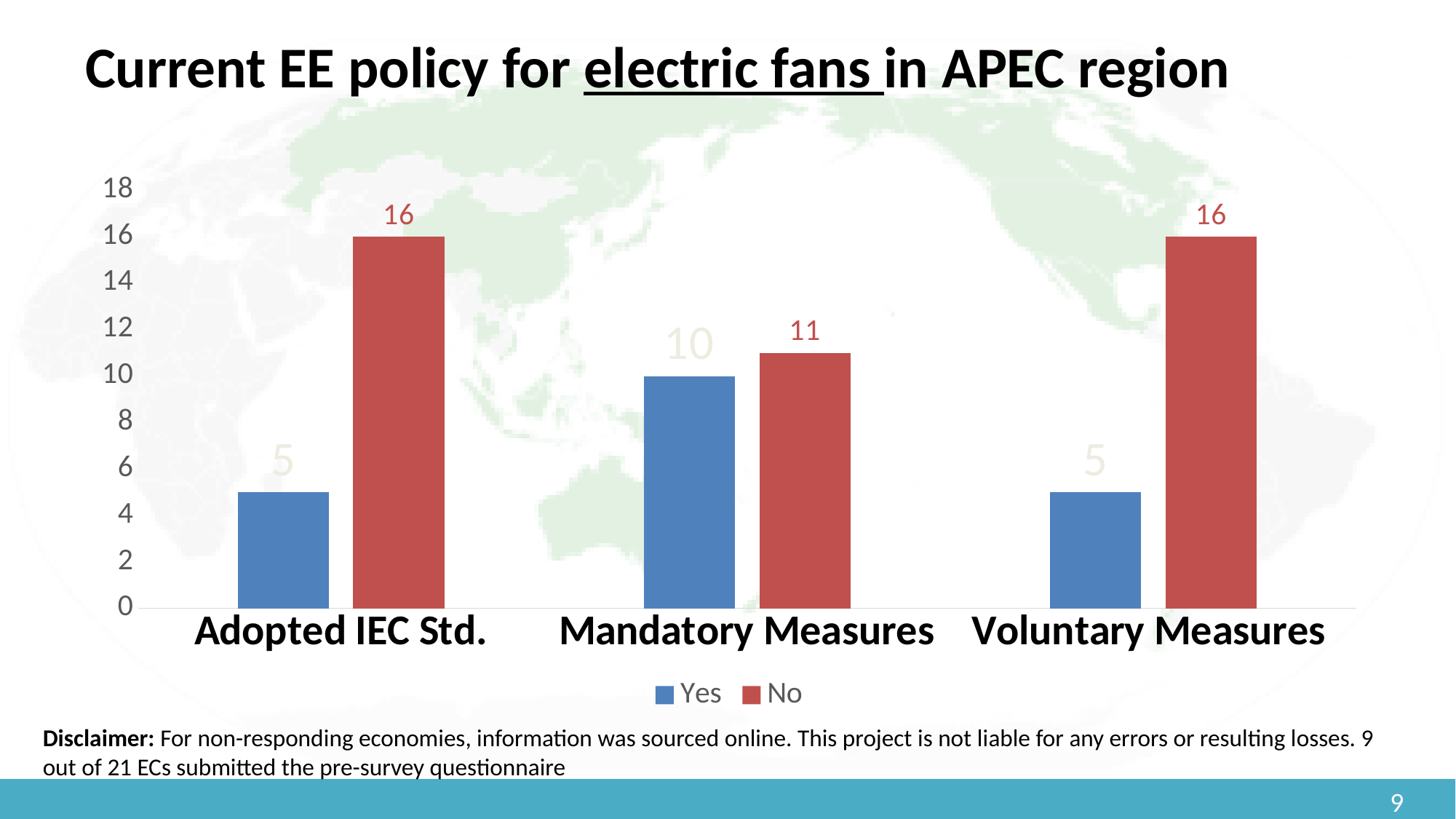
Which category has the highest 'Yes' value? Mandatory Measures How many series does the legend list? 2 What is the 'No' value for Voluntary Measures? 16 What is the 'Yes' value for Adopted IEC Std.? 5 Which is larger for Mandatory Measures, the 'Yes' value or the 'No' value? No What colour represents the 'No' series? Red What is the 'Yes' value for Mandatory Measures? 10 What is the 'No' value for Mandatory Measures? 11 How many categories are shown on the x axis? 3 What kind of chart is shown on the slide? Bar chart Which category has the lowest 'No' value? Mandatory Measures What is the difference between the 'No' and 'Yes' values for Adopted IEC Std.? 11